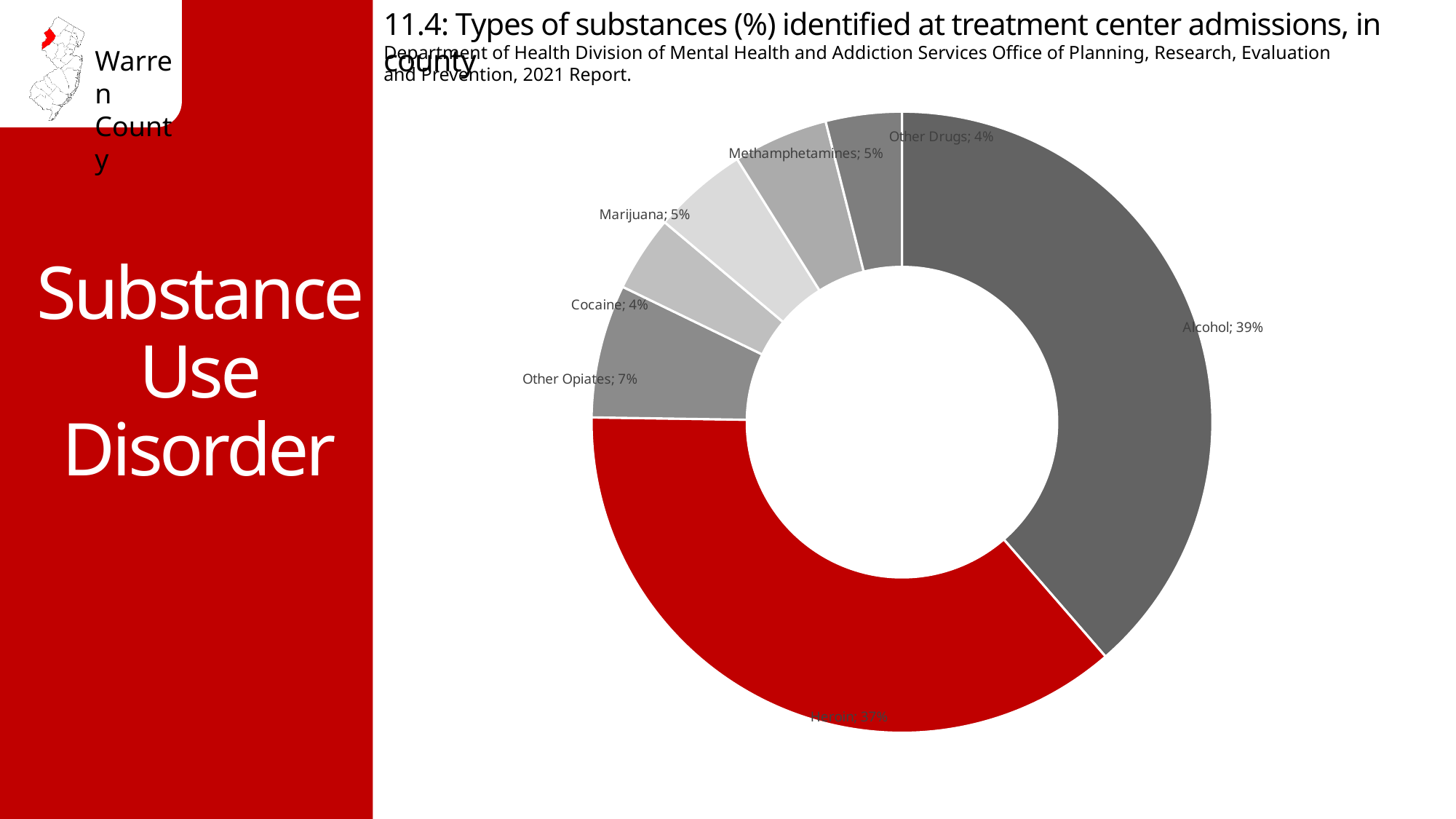
What percentage is shown for Other Drugs? 4% Which substance has the largest share of admissions? Alcohol What is the difference in percentage points between Alcohol and Heroin? 2 What percentage of treatment center admissions identified Alcohol? 39% Which slice of the chart is coloured red? Heroin What is the combined percentage for Marijuana and Cocaine? 9% What percentage is shown for Methamphetamines? 5% What percentage of treatment center admissions identified Heroin? 37% What kind of chart is shown on the slide? Pie chart (doughnut) What percentage is shown for Other Opiates? 7% Which is larger, the share for Other Opiates or the share for Cocaine? Other Opiates How many substance categories are shown in the chart? 7